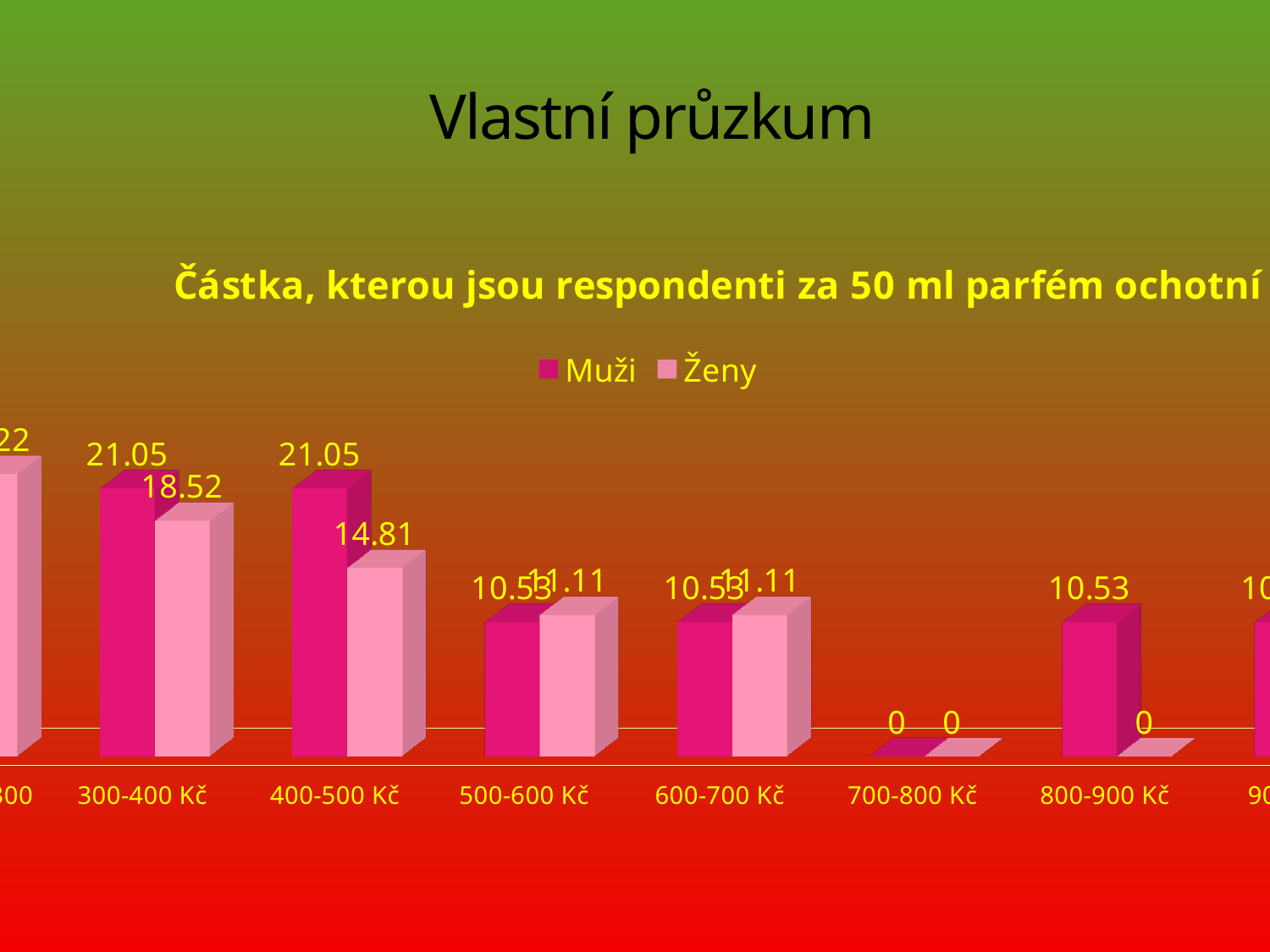
What are the two series named in the legend? Muži and Ženy What is the value for Ženy in the 700-800 Kč category? 0 Do the Ženy values rise or fall from the 300-400 Kč category to the 400-500 Kč category? Fall Which is larger in the 300-400 Kč category, the Muži value or the Ženy value? Muži What is the value for Muži in the 300-400 Kč category? 21.05 What is the value for Ženy in the 400-500 Kč category? 14.81 What kind of chart is shown on the slide? Bar chart Which is larger in the 800-900 Kč category, the Muži value or the Ženy value? Muži What is the difference between the Muži and Ženy values in the 400-500 Kč category? 6.24 What is the value for Muži in the 800-900 Kč category? 10.53 What is the value for Ženy in the 300-400 Kč category? 18.52 How many series does the legend list? 2